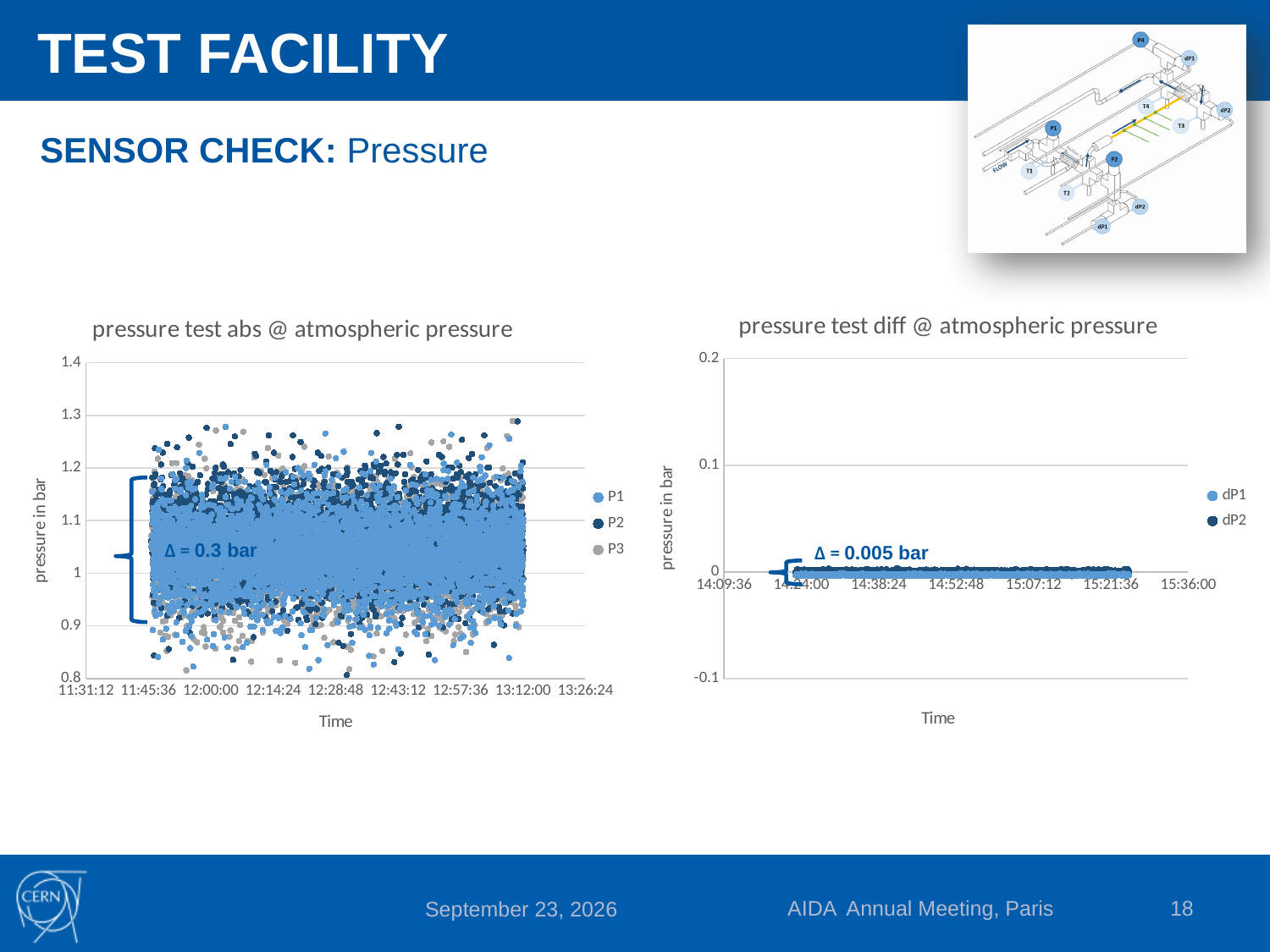
In the left chart, "pressure test abs @ atmospheric pressure", what spread (Δ) is annotated on the data? Δ = 0.3 bar How many series does the legend of the chart titled "pressure test diff @ atmospheric pressure" list? 2 What kind of chart is the left chart, "pressure test abs @ atmospheric pressure"? Scatter chart In the right chart, "pressure test diff @ atmospheric pressure", are the plotted dP1 values greater or less than 0.1? less In the left chart, "pressure test abs @ atmospheric pressure", are the plotted values greater or less than 1.4? less What are the legend entries of the right chart, "pressure test diff @ atmospheric pressure"? dP1, dP2 In the right chart, "pressure test diff @ atmospheric pressure", what spread (Δ) is annotated on the data? Δ = 0.005 bar In the left chart, "pressure test abs @ atmospheric pressure", are the plotted values greater or less than 0.8? greater How many series does the legend of the chart titled "pressure test abs @ atmospheric pressure" list? 3 What is the y-axis label of the left chart, "pressure test abs @ atmospheric pressure"? pressure in bar In the right chart, "pressure test diff @ atmospheric pressure", do the plotted values rise, fall, or stay flat along the time axis? stay flat How many charts are shown on the slide? 2